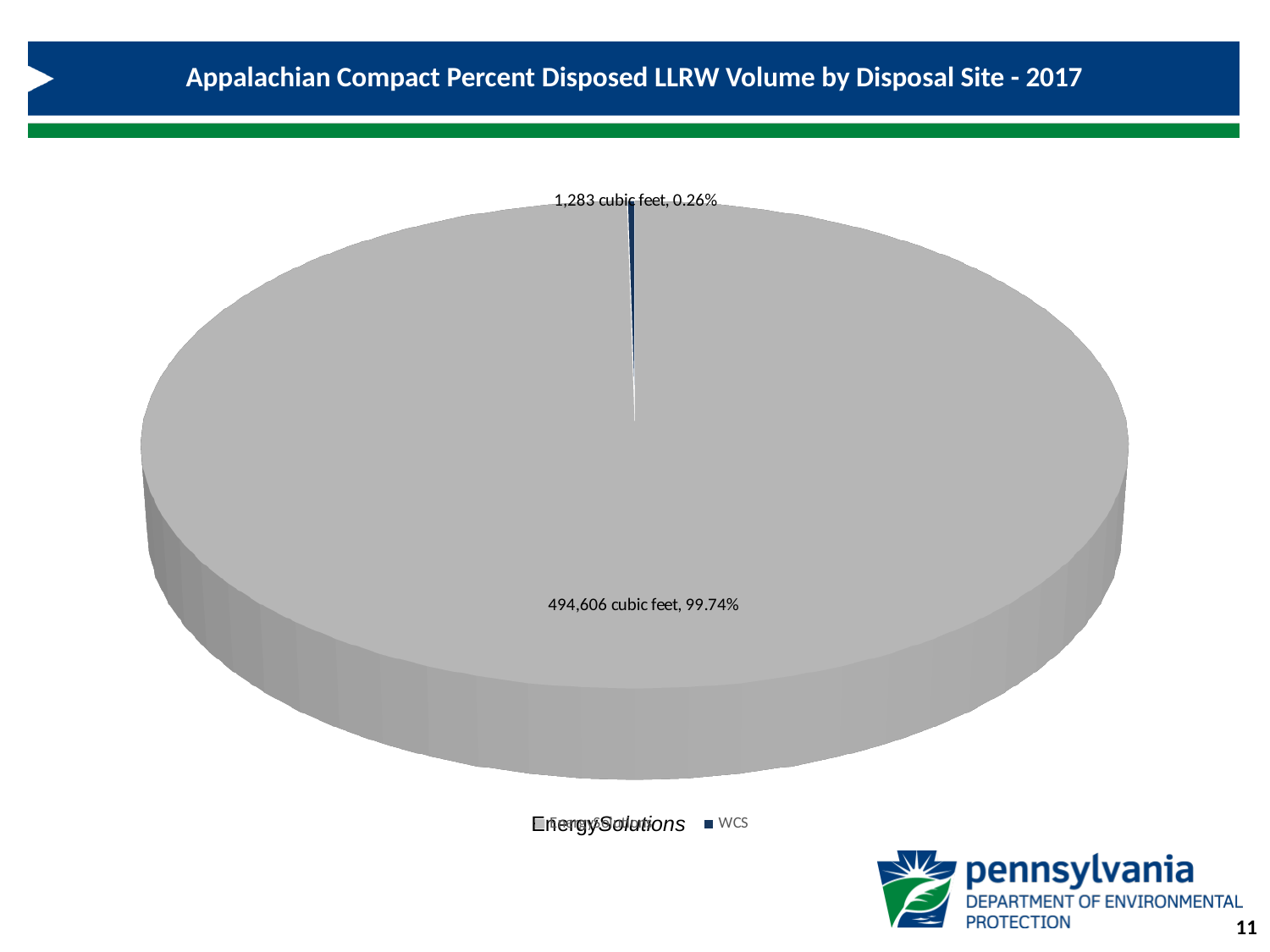
What volume is labelled for the EnergySolutions slice? 494,606 cubic feet How many slices does the pie chart have? 2 Which year does the chart title refer to? 2017 Which disposal site received the smallest share of the volume? WCS Which is larger, the volume disposed at EnergySolutions or at WCS? EnergySolutions What volume is labelled for the WCS slice? 1,283 cubic feet What percentage of the disposed LLRW volume went to EnergySolutions? 99.74% What kind of chart is shown on the slide? Pie chart Which disposal site received the largest share of the volume? EnergySolutions How many entries does the legend list? 2 What percentage of the disposed LLRW volume went to WCS? 0.26% What is the difference in cubic feet between the EnergySolutions and WCS volumes? 493,323 cubic feet